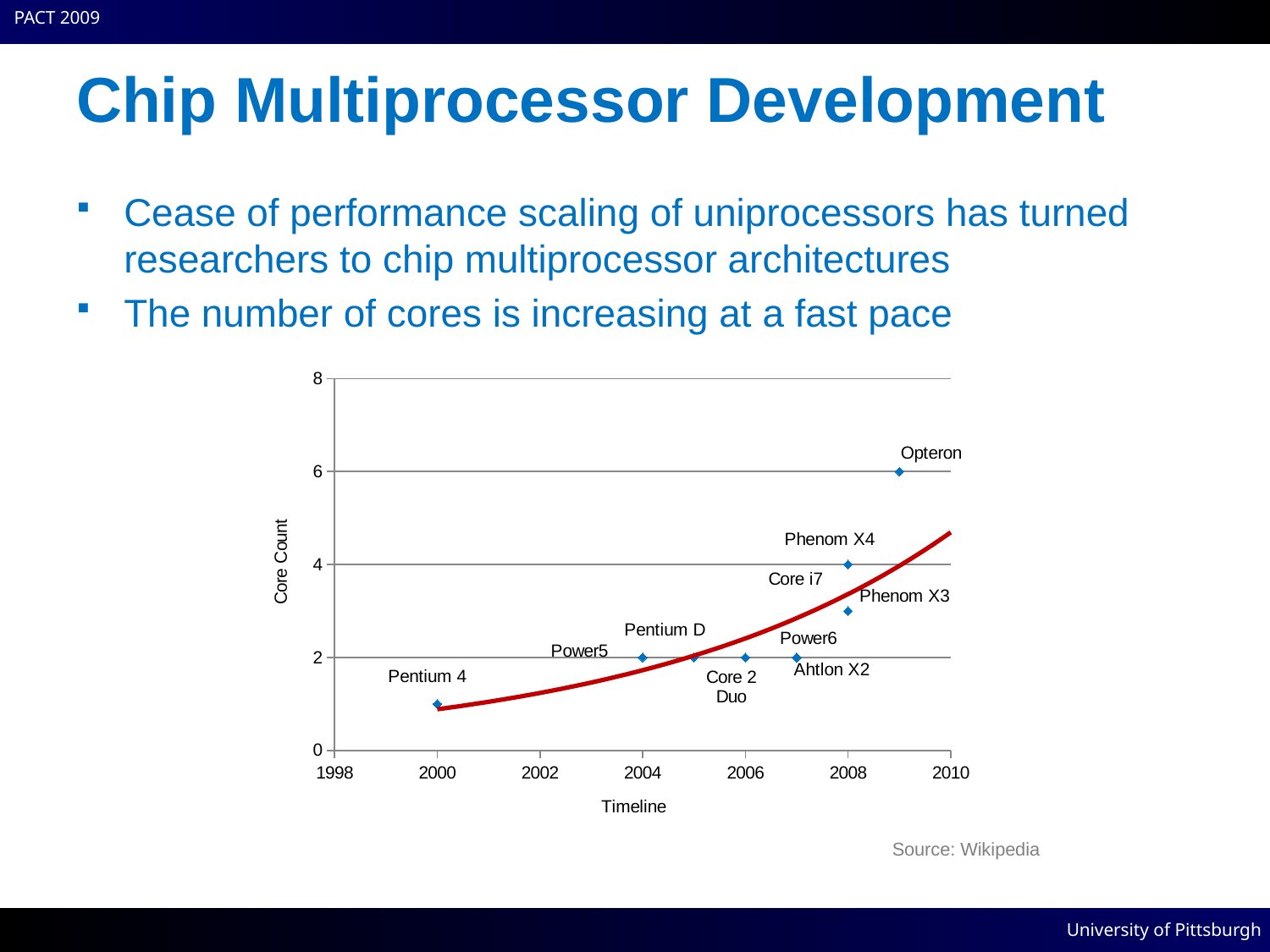
Does the core count generally rise or fall along the timeline? rise In which year is Pentium 4 plotted on the timeline? 2000 What is the difference in core count between Opteron and Phenom X4? 2 What is the core count plotted for Opteron? 6 Which has a higher core count, Phenom X3 or Opteron? Opteron What is the core count plotted for Power5? 2 What is the core count plotted for Phenom X4? 4 Which processor has the highest core count on the chart? Opteron What is the label of the vertical axis? Core Count Which processor has the lowest core count on the chart? Pentium 4 In which year is Core 2 Duo plotted on the timeline? 2006 Is the core count for Pentium 4 greater or less than 2? less